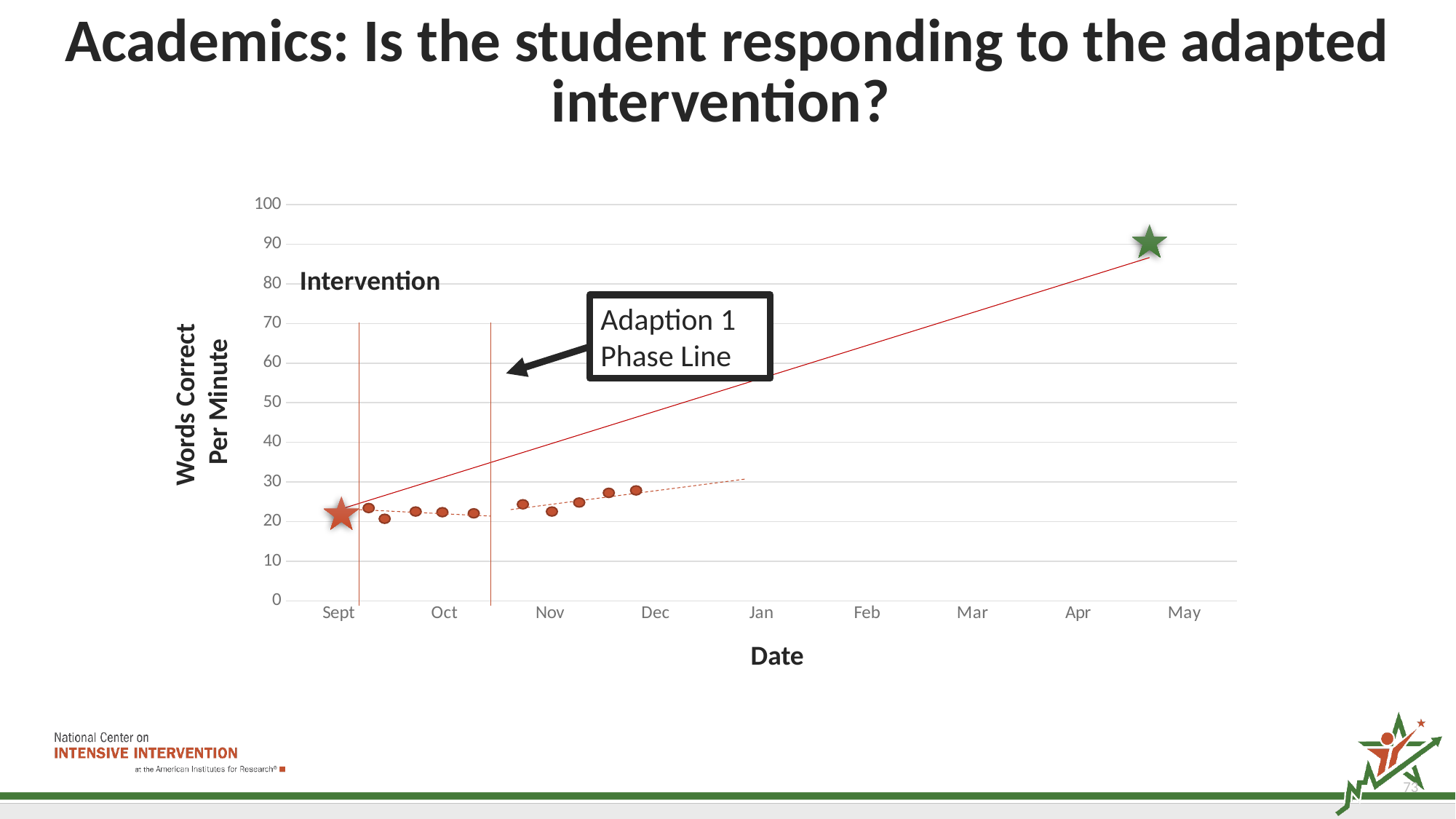
Is the value marked by the red star at Sept greater or less than 30? less What is the title of the horizontal axis of the chart? Date What kind of chart is shown on the slide? Line chart What does the boxed annotation with the arrow label the vertical orange line as? Adaption 1 Phase Line How many month labels are shown along the x axis of the chart? 9 Is the last plotted data point (near Dec) greater or less than 20? greater Do the plotted data points after the Adaption 1 Phase Line rise or fall over time? rise What is the highest value shown on the y axis of the chart? 100 Which is larger: the value of the green star near May or the value of the red star at Sept? the green star near May What is the title of the vertical axis of the chart? Words Correct Per Minute Are all of the plotted student data points greater or less than 40 words correct per minute? less